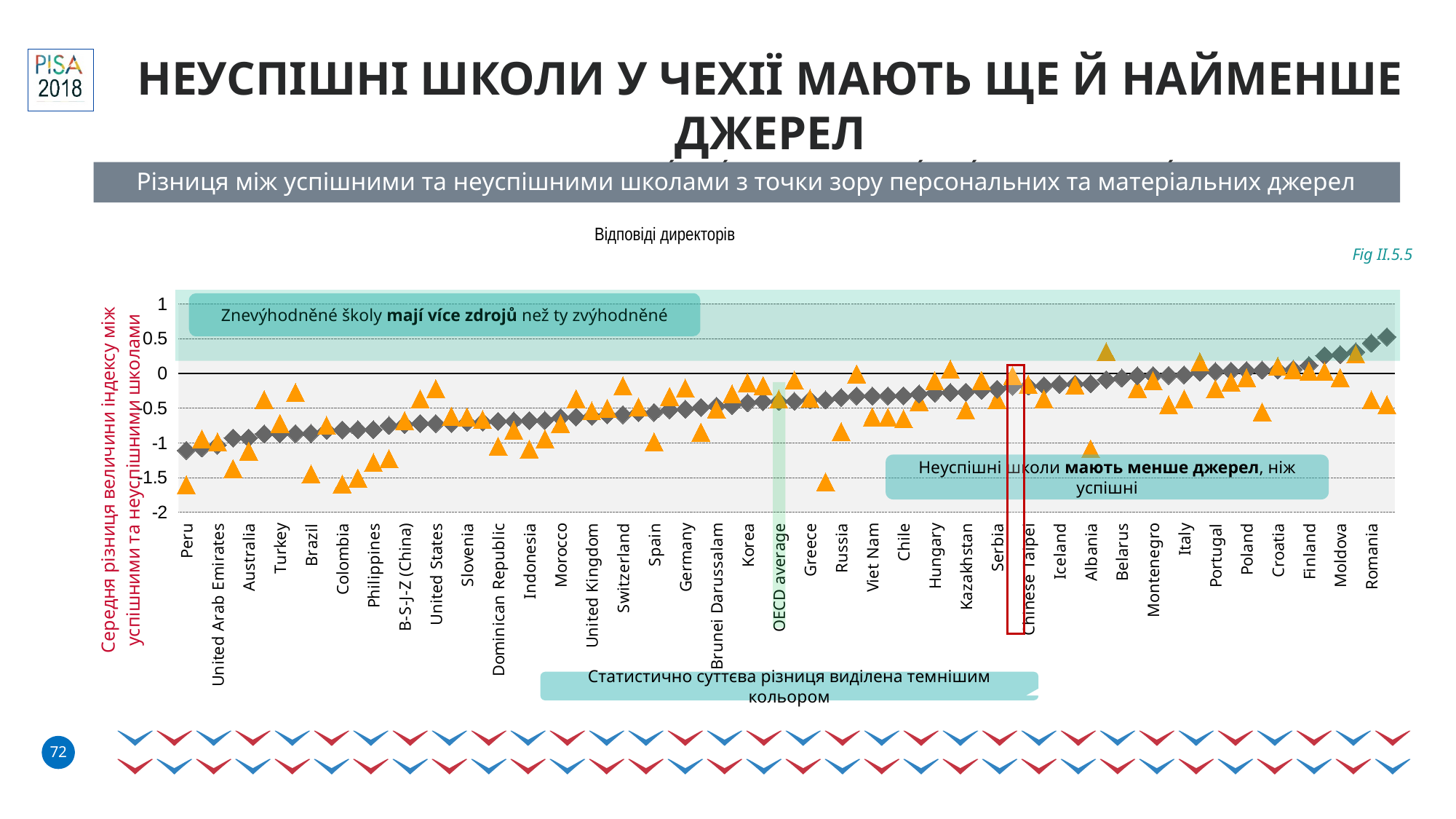
Which country has the lowest grey diamond value on the chart? Peru Is the grey diamond value for Colombia greater or less than -1? greater Is the grey diamond value for Peru greater or less than -1? less Is the orange triangle value for Greece greater or less than -1.5? greater Do the grey diamond values rise or fall moving from left to right along the x axis? rise What kind of chart is shown on the slide? scatter (dot) chart Which has the larger grey diamond value, Peru or Romania? Romania What figure number is given in the top right corner of the chart? Fig II.5.5